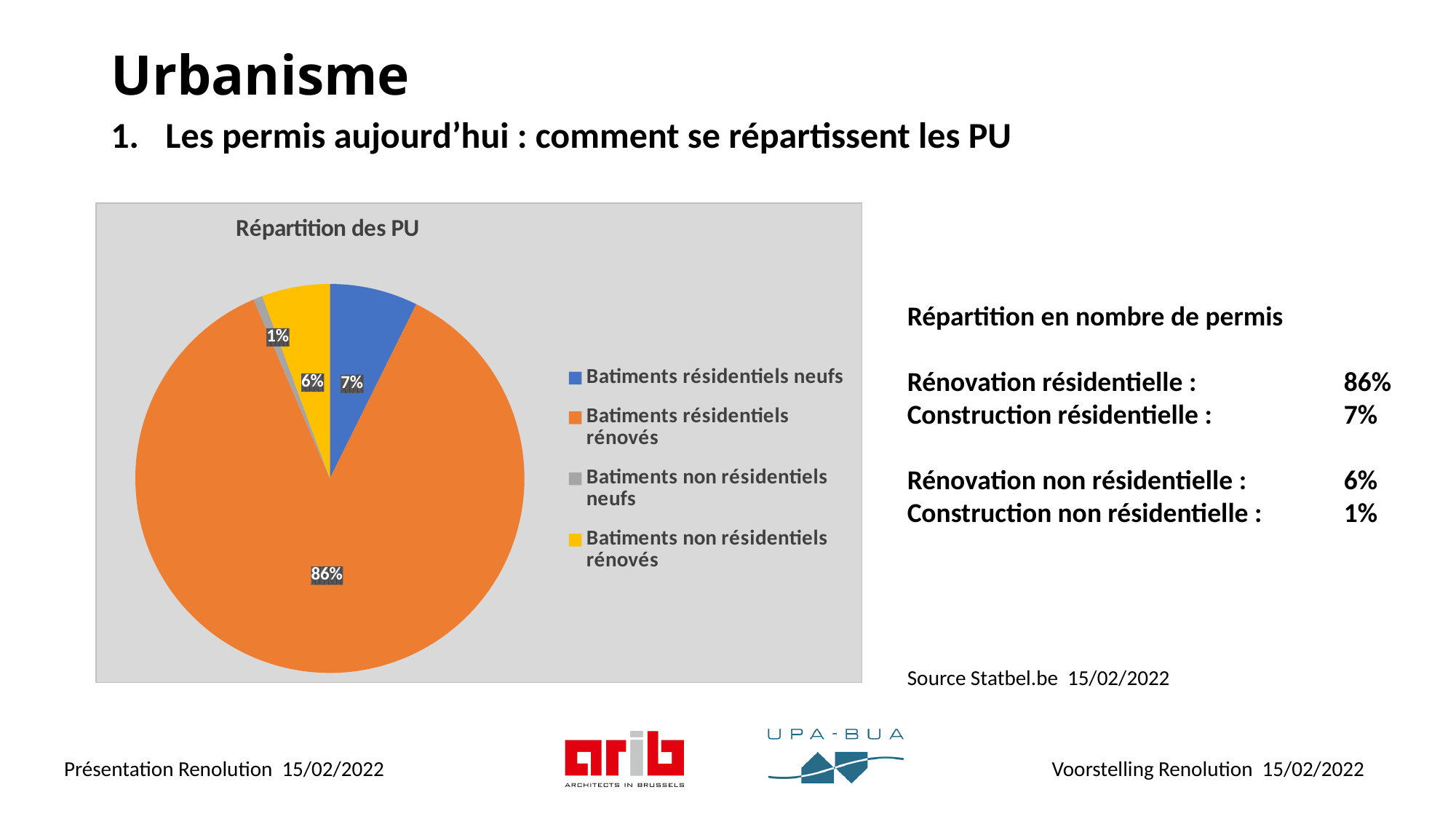
Which category has the smallest slice of the pie? Batiments non résidentiels neufs What share of the pie is 'Batiments non résidentiels rénovés'? 6% What type of chart is shown on the slide? Pie chart What is the title of the chart? Répartition des PU How many categories does the pie chart show? 4 What share of the pie is 'Batiments non résidentiels neufs'? 1% What share of the pie is 'Batiments résidentiels neufs'? 7% What colour is the slice for 'Batiments non résidentiels rénovés'? Yellow Which is larger: the share of 'Batiments résidentiels neufs' or 'Batiments non résidentiels rénovés'? Batiments résidentiels neufs What is the difference between the shares of 'Batiments résidentiels rénovés' and 'Batiments résidentiels neufs'? 79% Which category has the largest slice of the pie? Batiments résidentiels rénovés